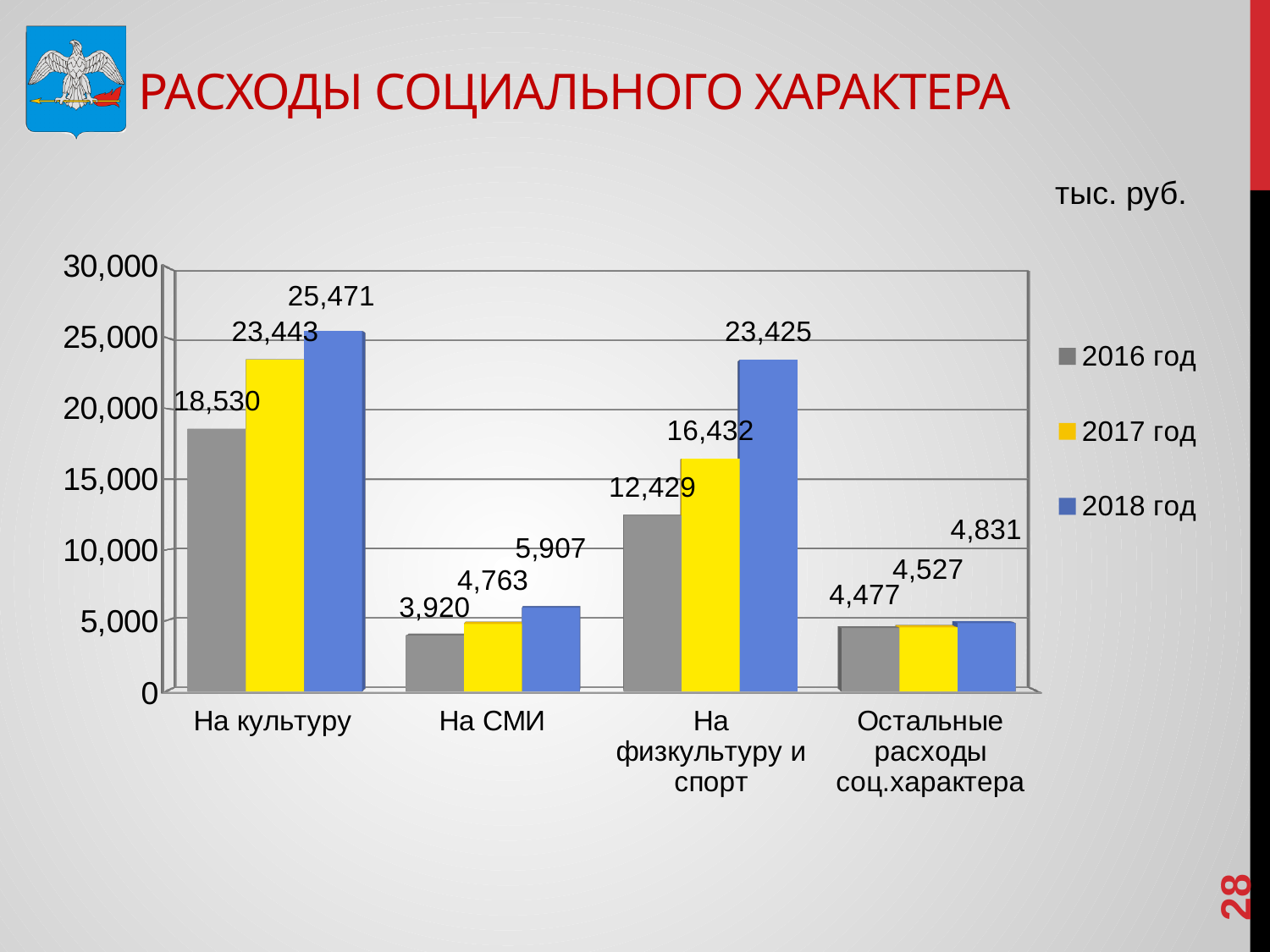
What is the value for 2016 год in the На СМИ category? 3,920 What kind of chart is shown on the slide? bar chart Is the 2016 год value for На культуру greater or less than 20,000? less How many series does the legend list? 3 What is the difference between the 2018 год and 2016 год values for На физкультуру и спорт? 10,996 How many categories are shown on the x axis? 4 Which category has the highest value for 2016 год? На культуру What is the value for 2018 год in the Остальные расходы соц.характера category? 4,831 Which is larger: the 2017 год value for На СМИ or the 2017 год value for Остальные расходы соц.характера? На СМИ Which category has the lowest value for 2018 год? Остальные расходы соц.характера What is the value for 2018 год in the На культуру category? 25,471 What is the value for 2017 год in the На физкультуру и спорт category? 16,432